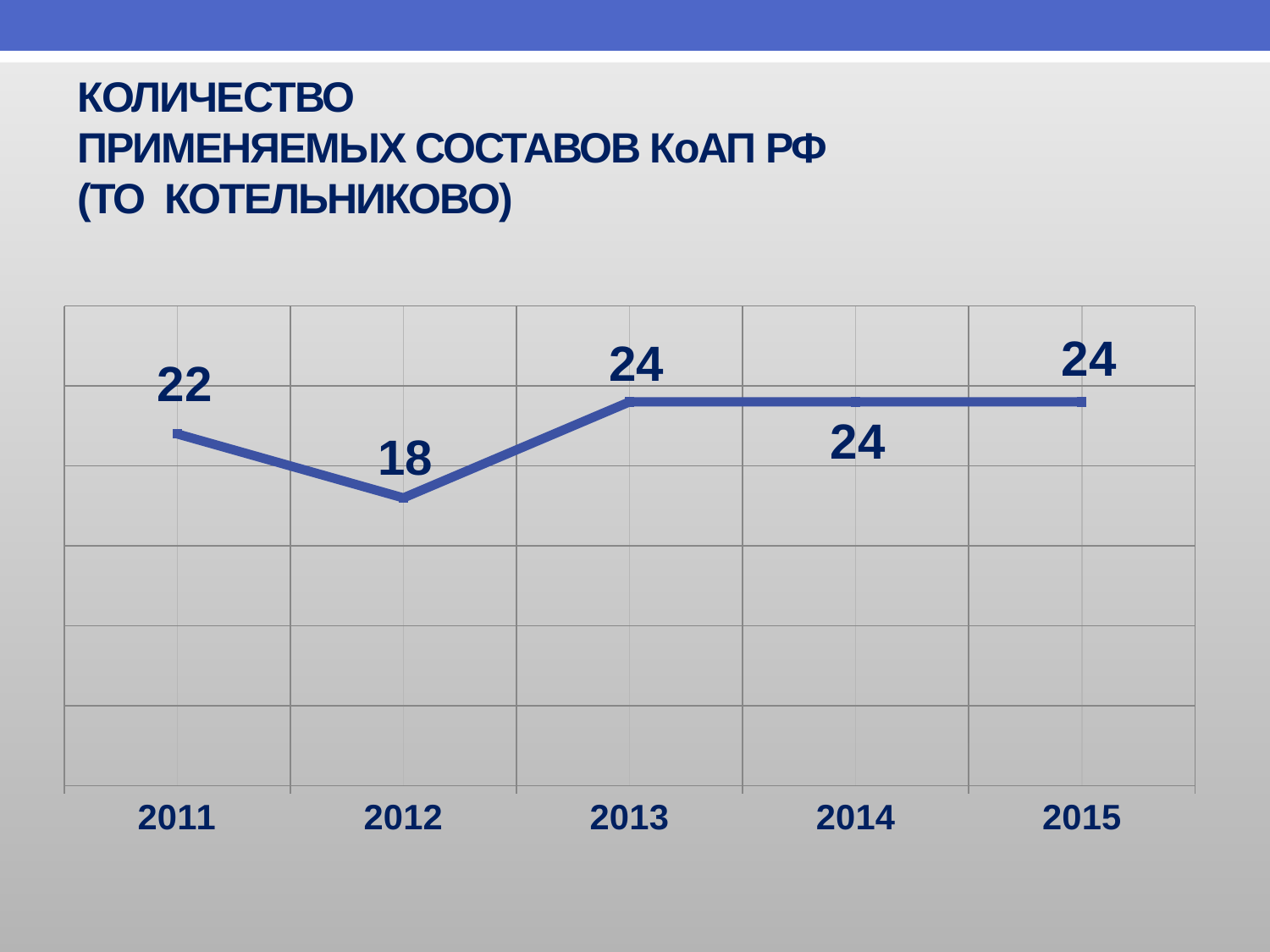
Which is larger, the value for 2011 or the value for 2012? 2011 How many years are plotted on the chart? 5 Does the value rise or fall from 2012 to 2013? rise What is the value for 2015? 24 Which year has the lowest value? 2012 What is the title of the chart on the slide? КОЛИЧЕСТВО ПРИМЕНЯЕМЫХ СОСТАВОВ КоАП РФ (ТО КОТЕЛЬНИКОВО) What is the difference between the values for 2013 and 2012? 6 What kind of chart is shown on the slide? line chart What is the difference between the values for 2011 and 2012? 4 What is the value for 2011? 22 What is the value for 2013? 24 What is the value for 2012? 18